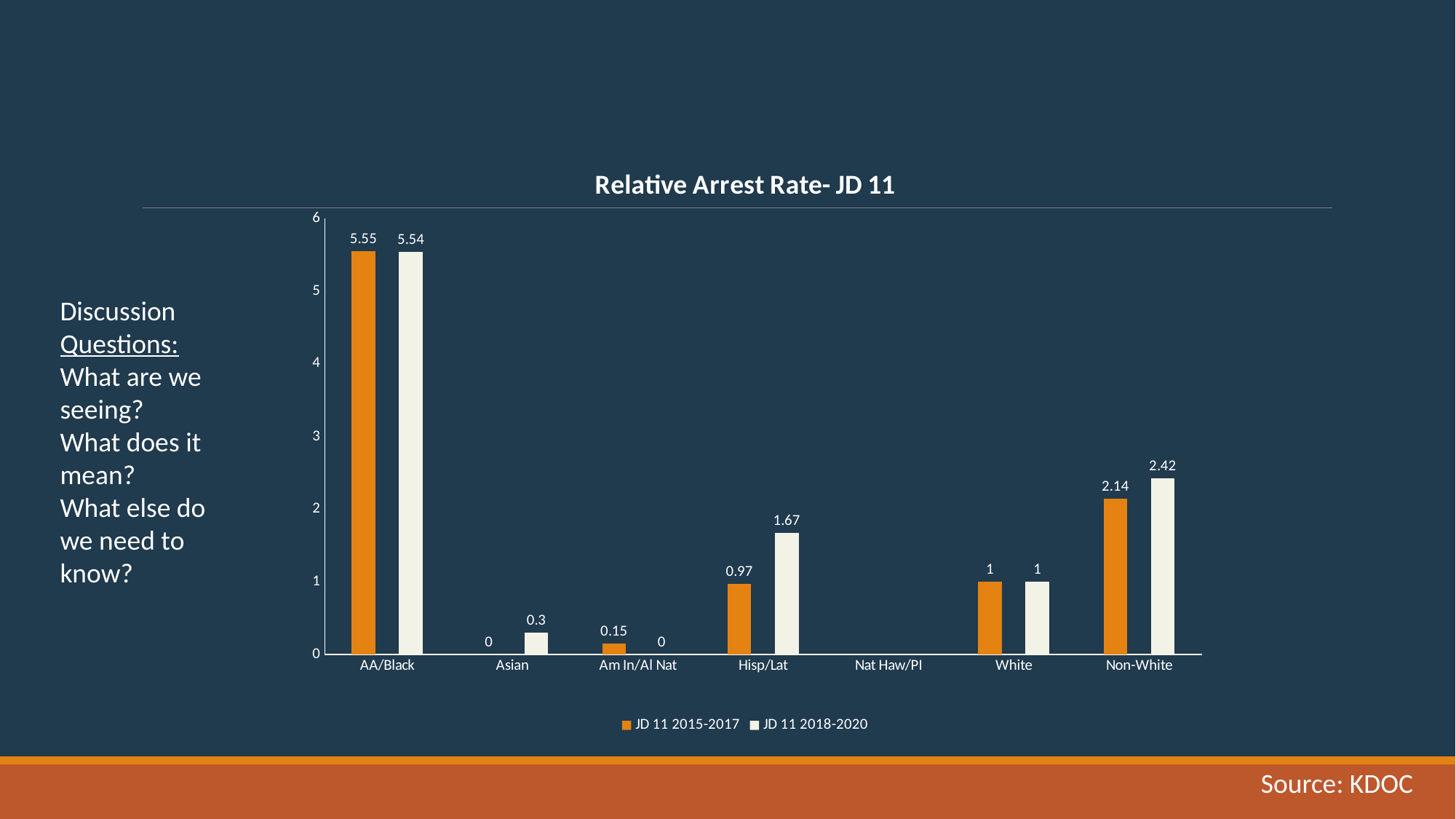
What is the difference between the JD 11 2018-2020 and JD 11 2015-2017 values for Hisp/Lat? 0.7 How many series does the legend list? 2 What is the JD 11 2015-2017 relative arrest rate for AA/Black? 5.55 What is the JD 11 2015-2017 value for Am In/Al Nat? 0.15 How many categories are shown on the x axis? 7 For Asian, which series has the larger value, JD 11 2015-2017 or JD 11 2018-2020? JD 11 2018-2020 What is the JD 11 2018-2020 value for Non-White? 2.42 Which category has the highest JD 11 2018-2020 value? AA/Black What kind of chart is shown on the slide? Bar chart What is the difference between the JD 11 2018-2020 and JD 11 2015-2017 values for Non-White? 0.28 What is the title of the chart? Relative Arrest Rate- JD 11 What is the JD 11 2018-2020 relative arrest rate for Hisp/Lat? 1.67